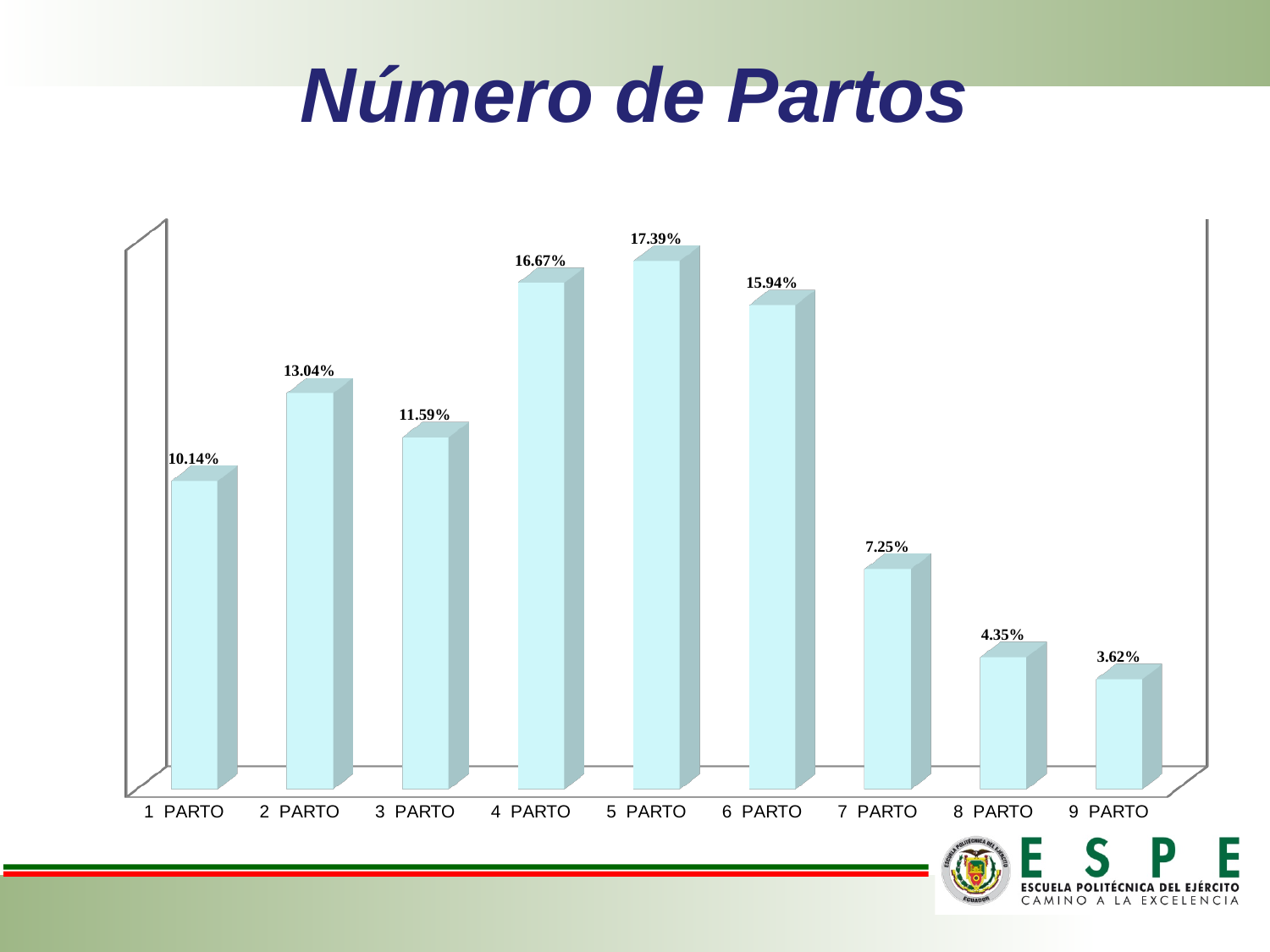
What kind of chart is shown on the slide? bar chart What is the value for 1 PARTO? 10.14% What is the value for 9 PARTO? 3.62% What is the difference between the values for 4 PARTO and 3 PARTO? 5.08% Which category has the lowest value? 9 PARTO What is the value for 7 PARTO? 7.25% What is the title of the chart? Número de Partos Which is larger, the value for 2 PARTO or the value for 6 PARTO? 6 PARTO Do the values rise or fall from 6 PARTO to 9 PARTO? fall How many categories are shown on the x axis? 9 What is the value for 5 PARTO? 17.39% Which category has the highest value? 5 PARTO